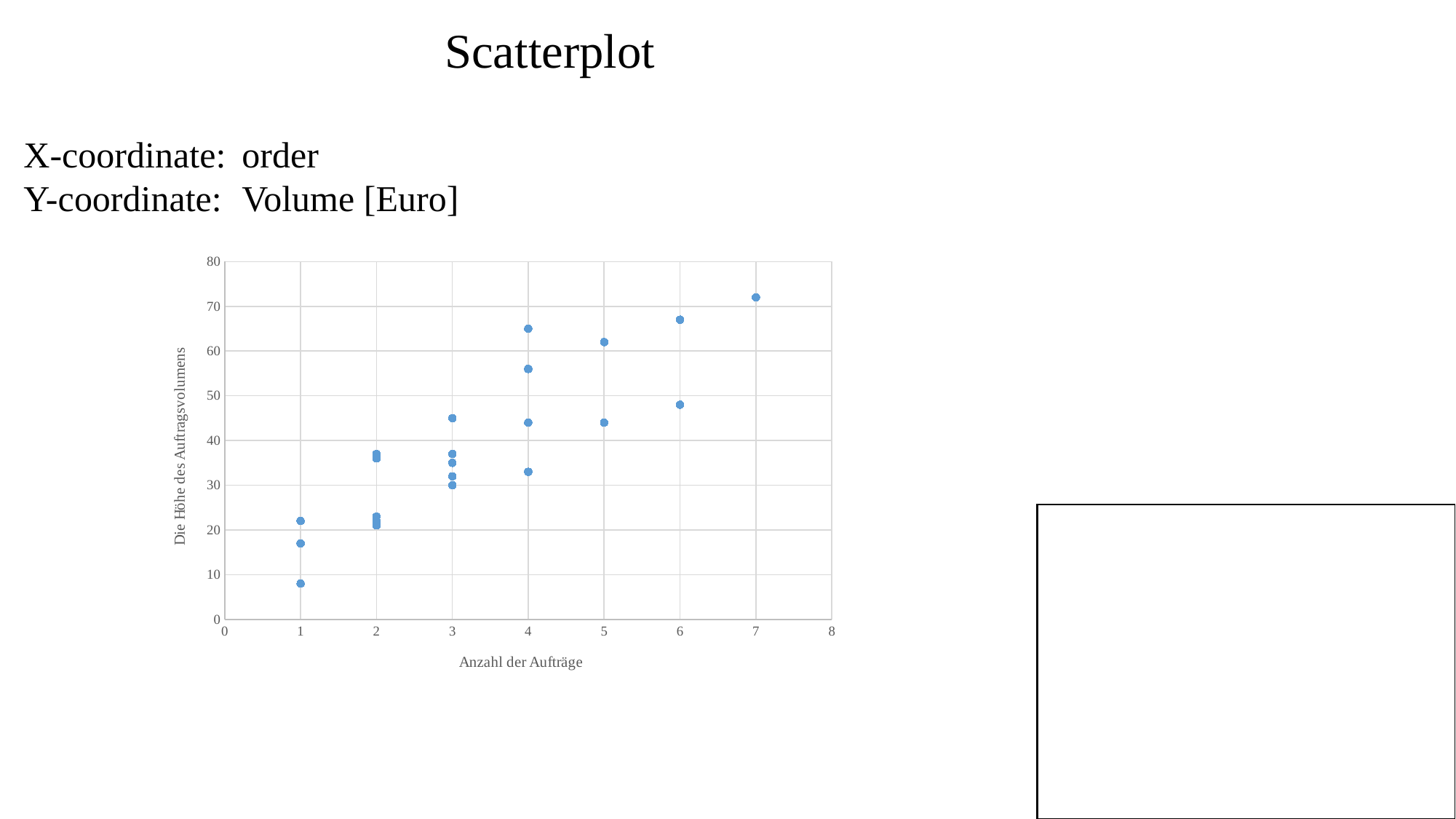
What kind of chart is shown on the slide? scatter plot What is the maximum value shown on the y axis of the chart? 80 Is the highest point at x = 4 greater or less than 60? greater Is the lowest point at x = 1 greater or less than 10? less Do the plotted volumes generally rise or fall as the number of orders increases along the x axis? rise At which x value (Anzahl der Aufträge) does the highest point on the chart appear? 7 At which x value (Anzahl der Aufträge) does the lowest point on the chart appear? 1 Is the highest point at x = 6 greater or less than 60? greater How many distinct x values (Anzahl der Aufträge) have points plotted on the chart? 7 What is the title of the x axis of the chart? Anzahl der Aufträge